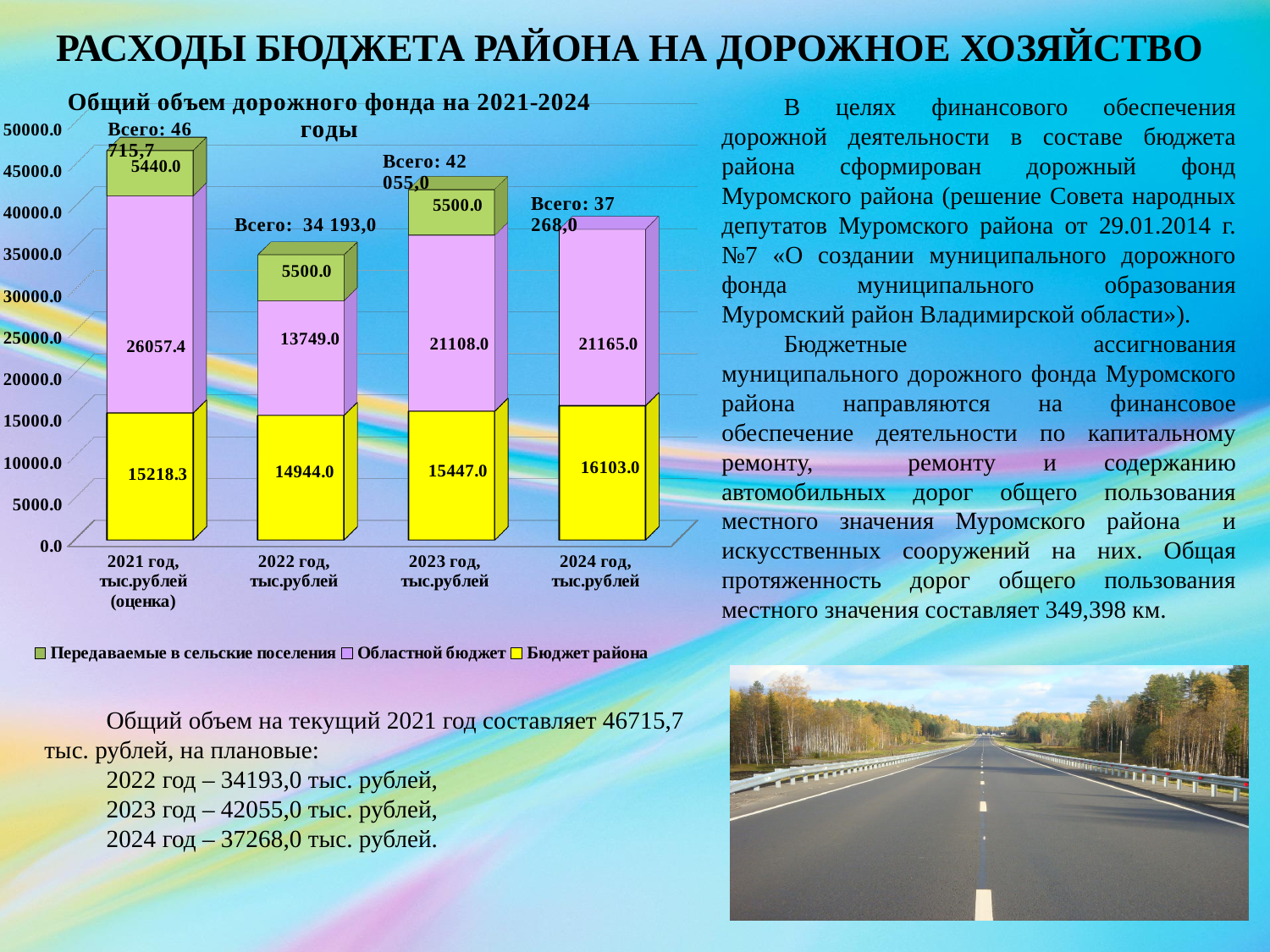
What kind of chart is shown on the slide? Stacked bar chart What is the value of Областной бюджет for 2024 год? 21165.0 Which is larger, Областной бюджет in 2021 год or in 2023 год? 2021 год What is the value of Бюджет района for 2021 год? 15218.3 In which year is Областной бюджет the lowest? 2022 год What is the value of Передаваемые в сельские поселения for 2023 год? 5500.0 What is the value of Областной бюджет for 2022 год? 13749.0 In which year is Бюджет района the highest? 2024 год What is the total (Всего) of the stacked bar for 2024 год? 37 268,0 How many series does the legend list? 3 What is the difference between Областной бюджет in 2021 год and in 2022 год? 12308.4 How many years (categories) are shown on the x axis? 4